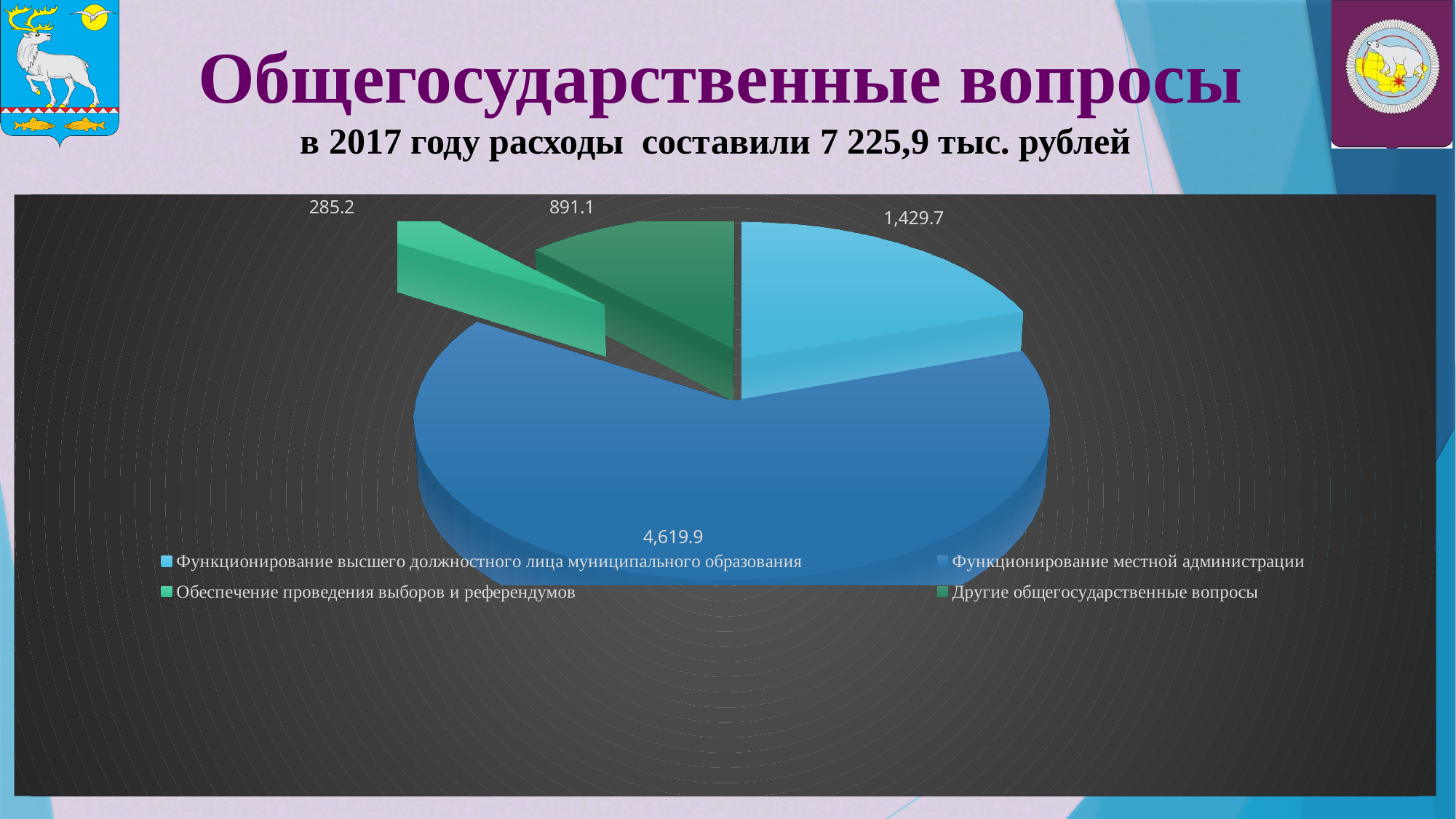
What type of chart is shown on the slide? pie chart Which category has the smallest slice of the pie? Обеспечение проведения выборов и референдумов What is the value for Другие общегосударственные вопросы? 891.1 Which is larger: the value for Другие общегосударственные вопросы or the value for Функционирование высшего должностного лица муниципального образования? Функционирование высшего должностного лица муниципального образования What is the value for Функционирование высшего должностного лица муниципального образования? 1,429.7 What is the difference between the values for Функционирование местной администрации and Функционирование высшего должностного лица муниципального образования? 3,190.2 Which category has the largest slice of the pie? Функционирование местной администрации What is the value for Функционирование местной администрации? 4,619.9 What is the total of all slices in the pie chart? 7,225.9 What is the value for Обеспечение проведения выборов и референдумов? 285.2 What is the difference between the values for Другие общегосударственные вопросы and Обеспечение проведения выборов и референдумов? 605.9 How many categories does the pie chart have? 4